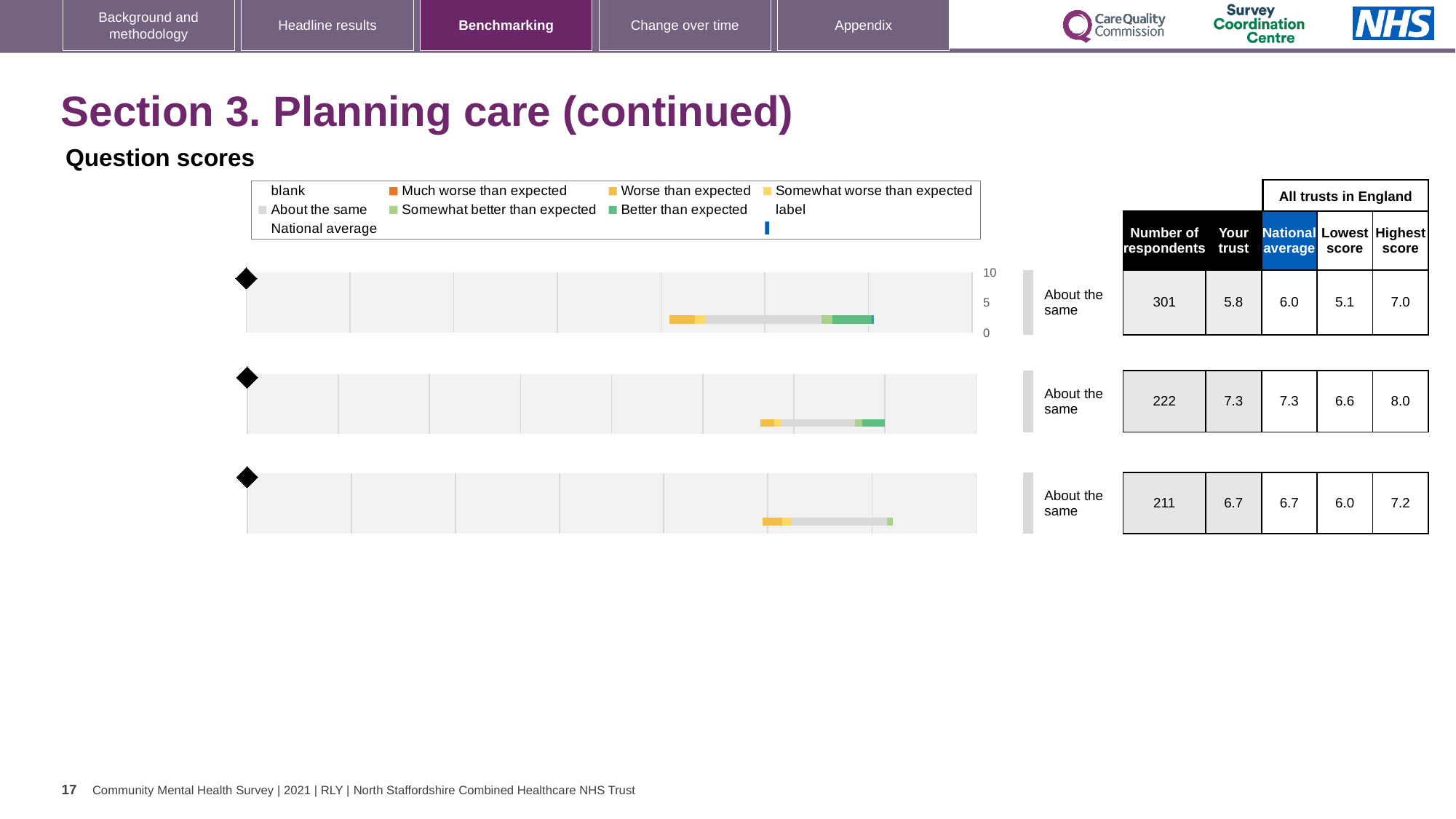
What benchmark category is shown next to the middle chart? About the same Is the 'Your trust' value for the top chart greater or less than 5? greater For the bottom chart, what is the lowest score among all trusts in England? 6.0 Which chart (top, middle or bottom) has the highest 'Your trust' score? Middle For the middle chart, how many respondents are there? 222 For the top chart, what is the 'Your trust' score? 5.8 Which chart (top, middle or bottom) has the fewest respondents? Bottom What is the maximum value shown on the vertical axis of the top chart? 10 For the top chart, which is larger: the 'Your trust' score or the national average? National average How many question score charts are shown on the slide? 3 What kind of chart is used for the question scores on this slide? Bar chart For the top chart, what is the difference between the highest score and the lowest score? 1.9